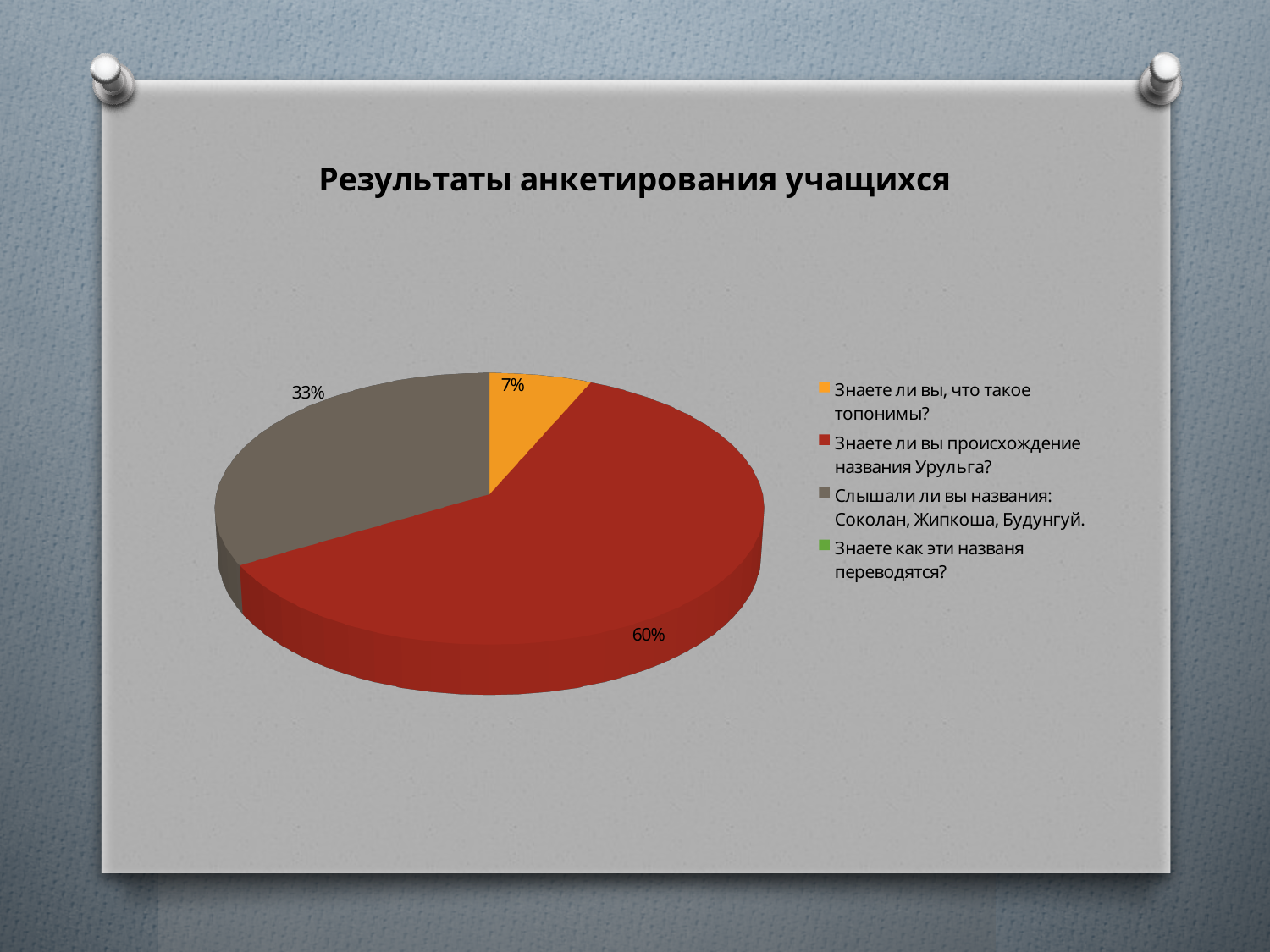
Which is larger: the share for "Слышали ли вы названия: Соколан, Жипкоша, Будунгуй." or the share for "Знаете ли вы, что такое топонимы?"? Слышали ли вы названия: Соколан, Жипкоша, Будунгуй. What is the title of the chart? Результаты анкетирования учащихся What percentage is shown for "Знаете ли вы, что такое топонимы?"? 7% What percentage is shown for "Знаете ли вы происхождение названия Урульга?"? 60% What percentage is shown for "Слышали ли вы названия: Соколан, Жипкоша, Будунгуй."? 33% What is the difference in percentage points between the 60% slice and the 33% slice? 27 What is the difference in percentage points between the 33% slice and the 7% slice? 26 What type of chart is shown on the slide? pie chart Which legend entry corresponds to the largest slice of the pie? Знаете ли вы происхождение названия Урульга? Which of the three labeled slices is the smallest? Знаете ли вы, что такое топонимы? How many entries does the legend list? 4 What colour is the slice labeled 60%? red